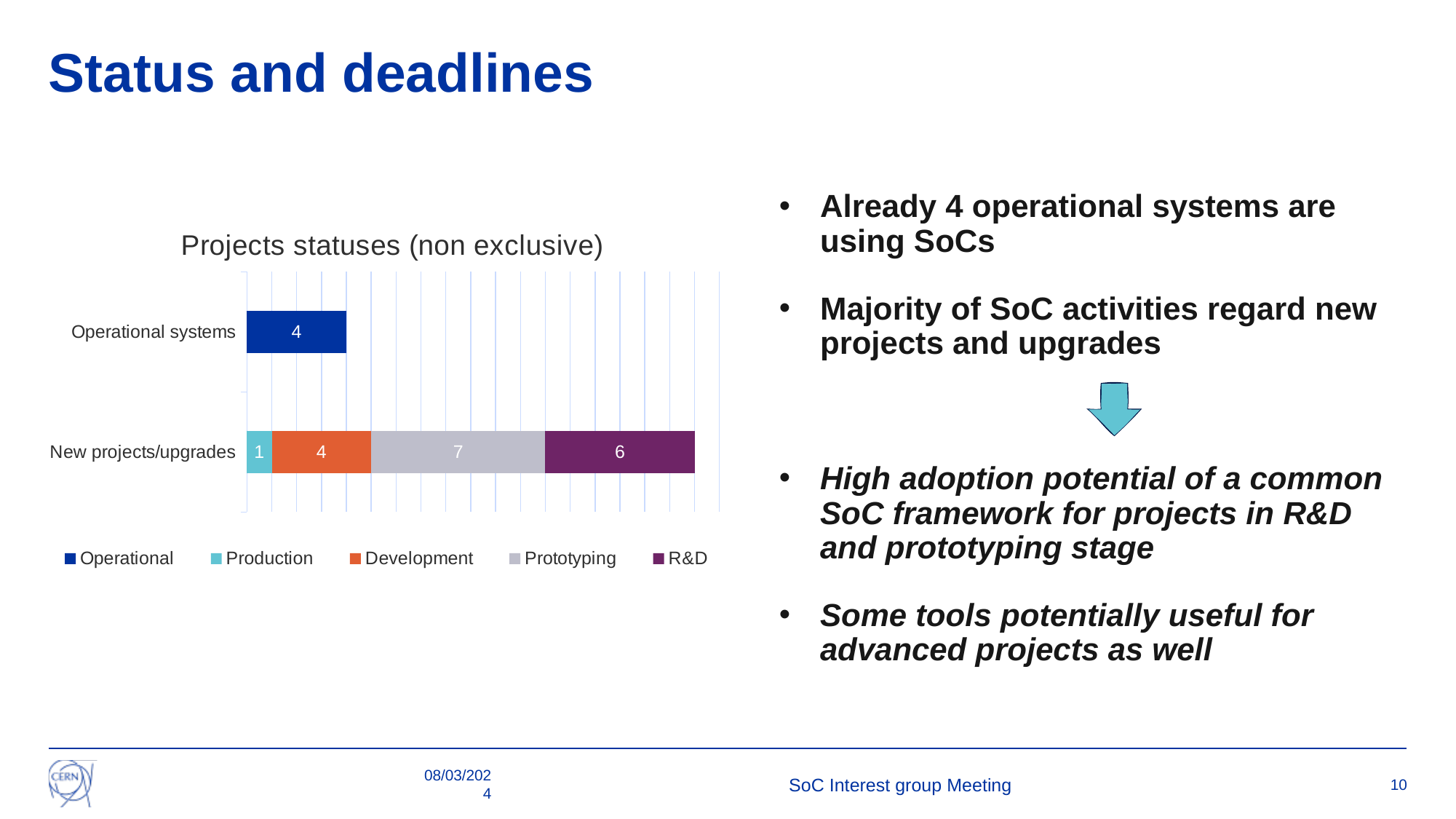
What is the Production value for New projects/upgrades? 1 What is the Operational value for Operational systems? 4 What is the total of the New projects/upgrades stacked bar? 18 What is the Prototyping value for New projects/upgrades? 7 What is the R&D value for New projects/upgrades? 6 How many series does the chart legend list? 5 Which series has the largest value in the New projects/upgrades bar? Prototyping What kind of chart is shown on the slide? Stacked bar chart Which series has the smallest value in the New projects/upgrades bar? Production What is the title of the chart? Projects statuses (non exclusive) What is the Development value for New projects/upgrades? 4 How many categories are shown on the chart's vertical axis? 2